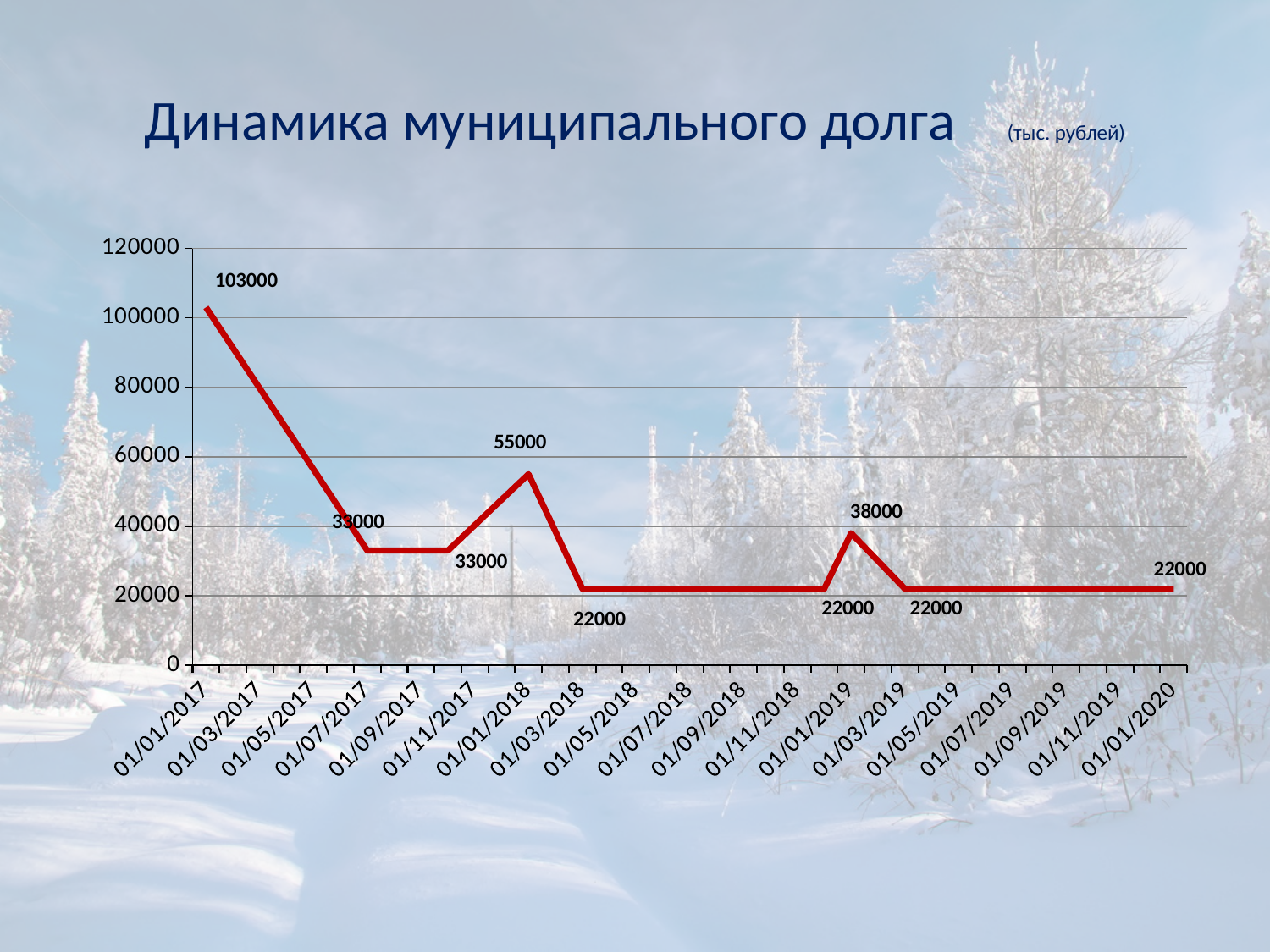
What is the value of the municipal debt on 01/01/2017? 103000 What is the value at the peak of the line in early 2019? 38000 What is the difference between the debt on 01/01/2017 and on 01/01/2020? 81000 Which is larger, the debt on 01/01/2017 or on 01/01/2018? 01/01/2017 On which date is the municipal debt highest? 01/01/2017 What is the value of the municipal debt on 01/01/2020? 22000 How many date labels are shown on the x axis? 19 Does the municipal debt overall rise or fall from 01/01/2017 to 01/01/2020? fall What kind of chart is shown on the slide? line chart What is the value of the municipal debt on 01/07/2017? 33000 Is the value on 01/09/2018 greater or less than 40000? less What is the value of the municipal debt on 01/01/2018? 55000